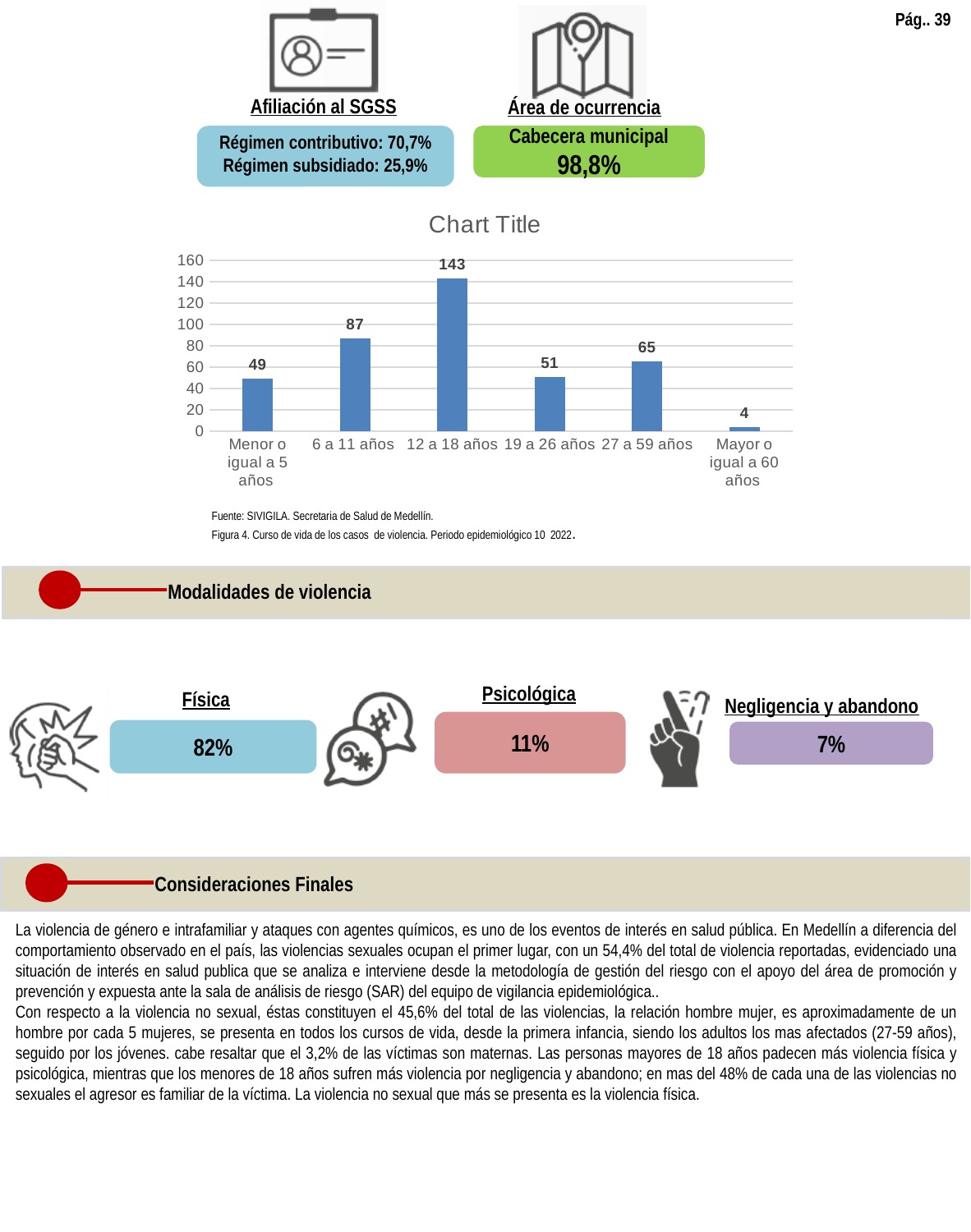
Which age group has the lowest value in the bar chart? Mayor o igual a 60 años Which is larger in the bar chart: the value for '27 a 59 años' or the value for '19 a 26 años'? 27 a 59 años What is the difference between the values for 'Menor o igual a 5 años' and 'Mayor o igual a 60 años' in the bar chart? 45 Is the value for '6 a 11 años' in the bar chart greater or less than 100? less What is the title displayed above the bar chart? Chart Title How many age-group categories are shown in the bar chart? 6 What is the difference between the values for '12 a 18 años' and '6 a 11 años' in the bar chart? 56 What is the value for the '6 a 11 años' category in the bar chart? 87 What is the value for the 'Mayor o igual a 60 años' category in the bar chart? 4 Which age group has the highest value in the bar chart? 12 a 18 años What is the value for the '12 a 18 años' category in the bar chart? 143 What kind of chart is shown on the slide? bar chart